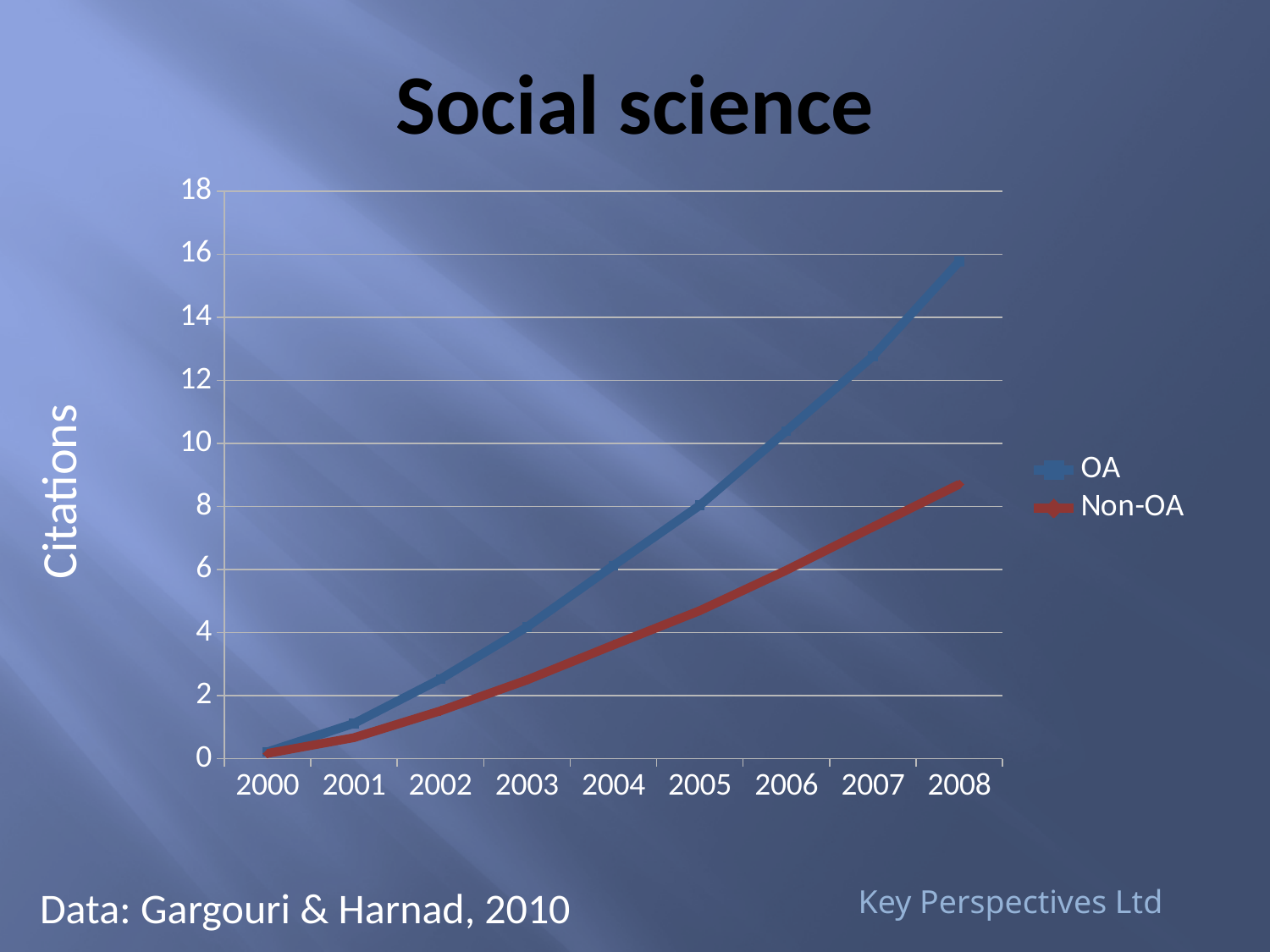
Is the OA value for 2007 greater or less than 12? greater Is the Non-OA value for 2008 greater or less than 10? less Do the OA citations rise or fall from 2000 to 2008? rise Is the Non-OA value for 2002 greater or less than 2? less How many years are shown along the x axis? 9 What is the title of the chart? Social science Which series has the higher value in 2008, OA or Non-OA? OA How many series does the legend list? 2 What kind of chart is shown on the slide? line chart What is the label on the y axis? Citations